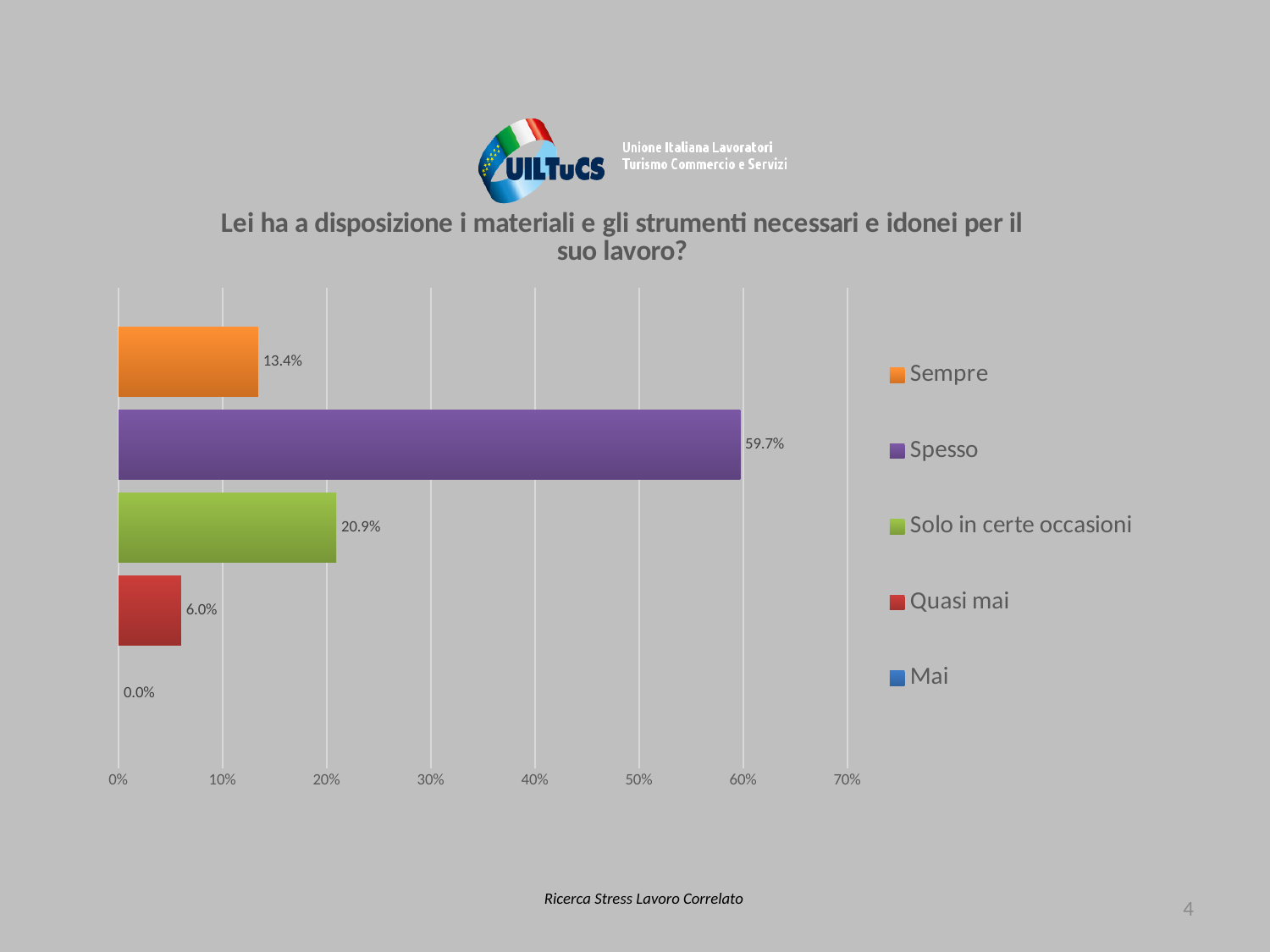
Which category has the highest value? Spesso What colour is the bar for Spesso? Purple What is the value for Sempre? 13.4% Which is larger, the value for Sempre or the value for Solo in certe occasioni? Solo in certe occasioni What is the difference between the values for Spesso and Solo in certe occasioni? 38.8% What is the value for Mai? 0.0% What is the value for Solo in certe occasioni? 20.9% Which category has the lowest value? Mai How many categories does the legend list? 5 What is the value for Spesso? 59.7% What is the value for Quasi mai? 6.0% What kind of chart is shown on the slide? Bar chart